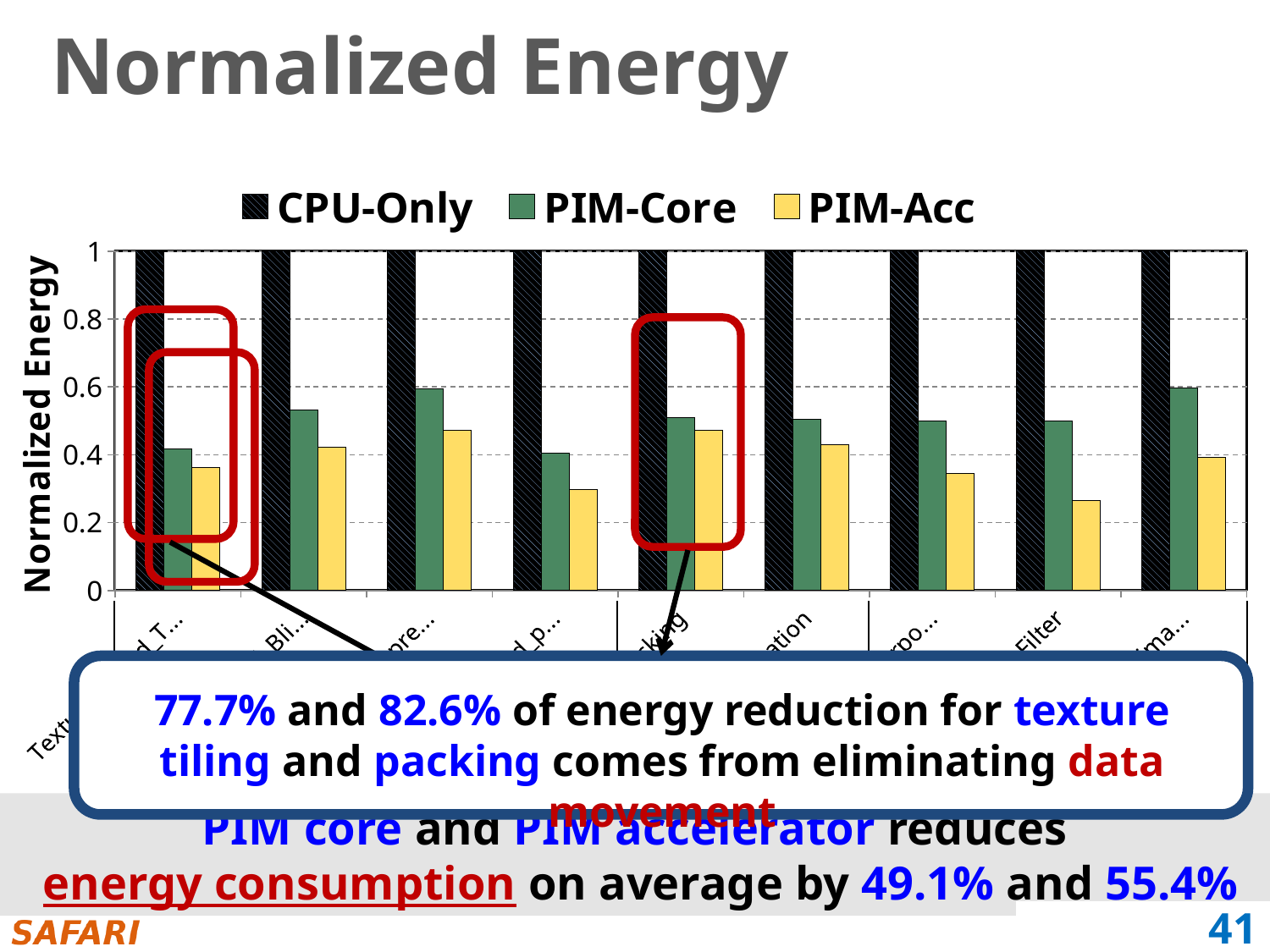
For the Filter category, which is larger: the PIM-Core value or the PIM-Acc value? PIM-Core Which series are listed in the legend? CPU-Only, PIM-Core, PIM-Acc Is the PIM-Core value for Filter greater or less than 0.4? greater What kind of chart is shown on the slide? bar chart Which series has the lowest bar for the Filter category? PIM-Acc Which series has the highest bar in every category? CPU-Only How many series does the legend list? 3 What is the normalized energy value of the CPU-Only series for the Filter category? 1 How many groups of bars (categories) are plotted? 9 Is the PIM-Acc value for Filter greater or less than 0.4? less What is the label of the y axis? Normalized Energy Is the PIM-Acc value for Filter greater or less than 0.2? greater